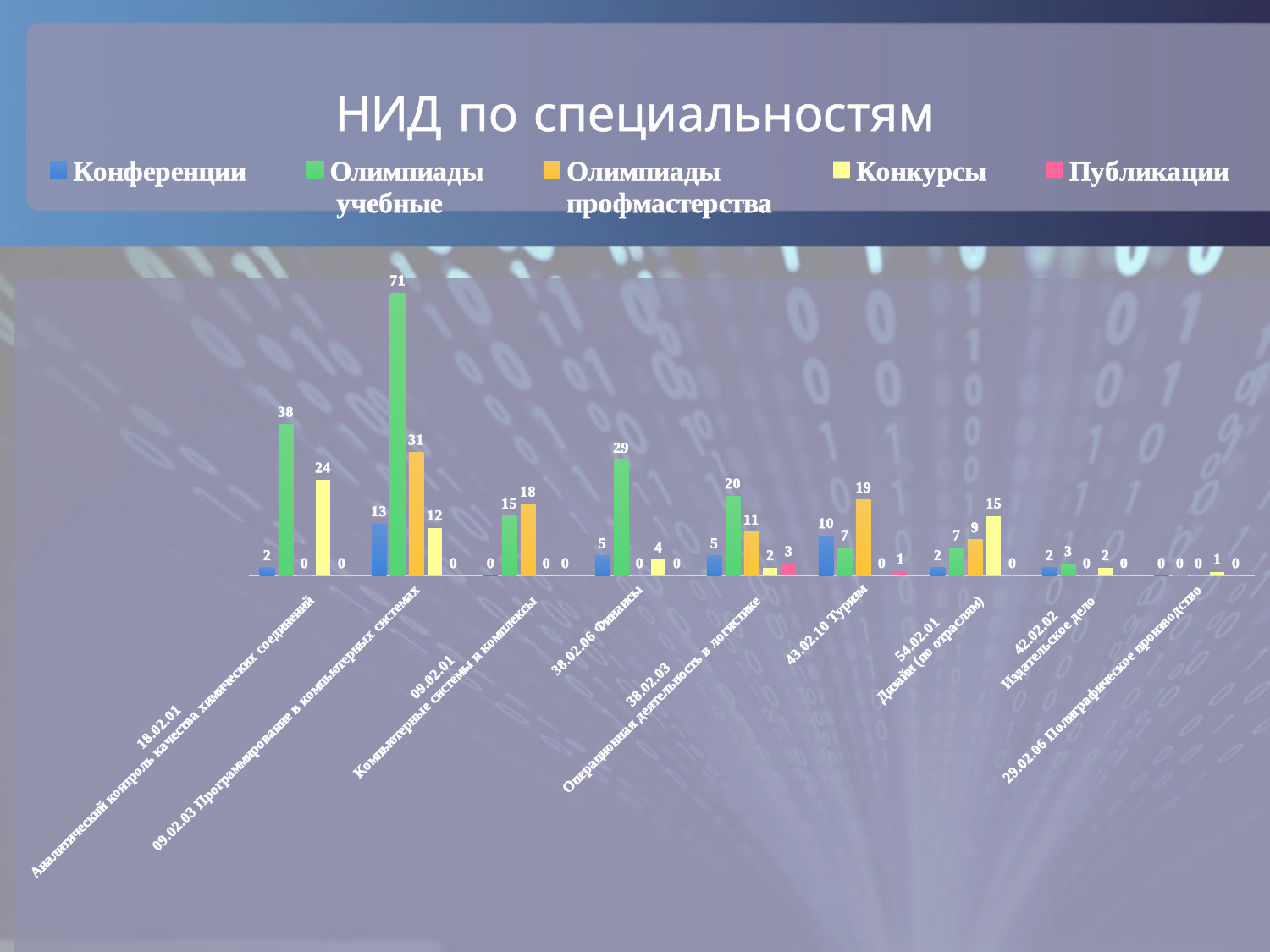
How many specialty categories are shown on the x axis? 9 What type of chart is shown on the slide? bar chart Which specialty has the highest value for Конференции? 09.02.03 Программирование в компьютерных системах How many series does the legend list? 5 What is the value of Публикации for 38.02.03 Операционная деятельность в логистике? 3 What is the value of Конкурсы for 18.02.01 Аналитический контроль качества химических соединений? 24 Which specialty has the highest value for Конкурсы? 18.02.01 Аналитический контроль качества химических соединений What is the value of Олимпиады профмастерства for 43.02.10 Туризм? 19 Which is larger for 54.02.01 Дизайн (по отраслям): Конкурсы or Олимпиады профмастерства? Конкурсы What is the title of the chart? НИД по специальностям What is the value of Олимпиады учебные for 09.02.03 Программирование в компьютерных системах? 71 What is the difference between Олимпиады учебные for 09.02.03 Программирование в компьютерных системах and for 18.02.01 Аналитический контроль качества химических соединений? 33